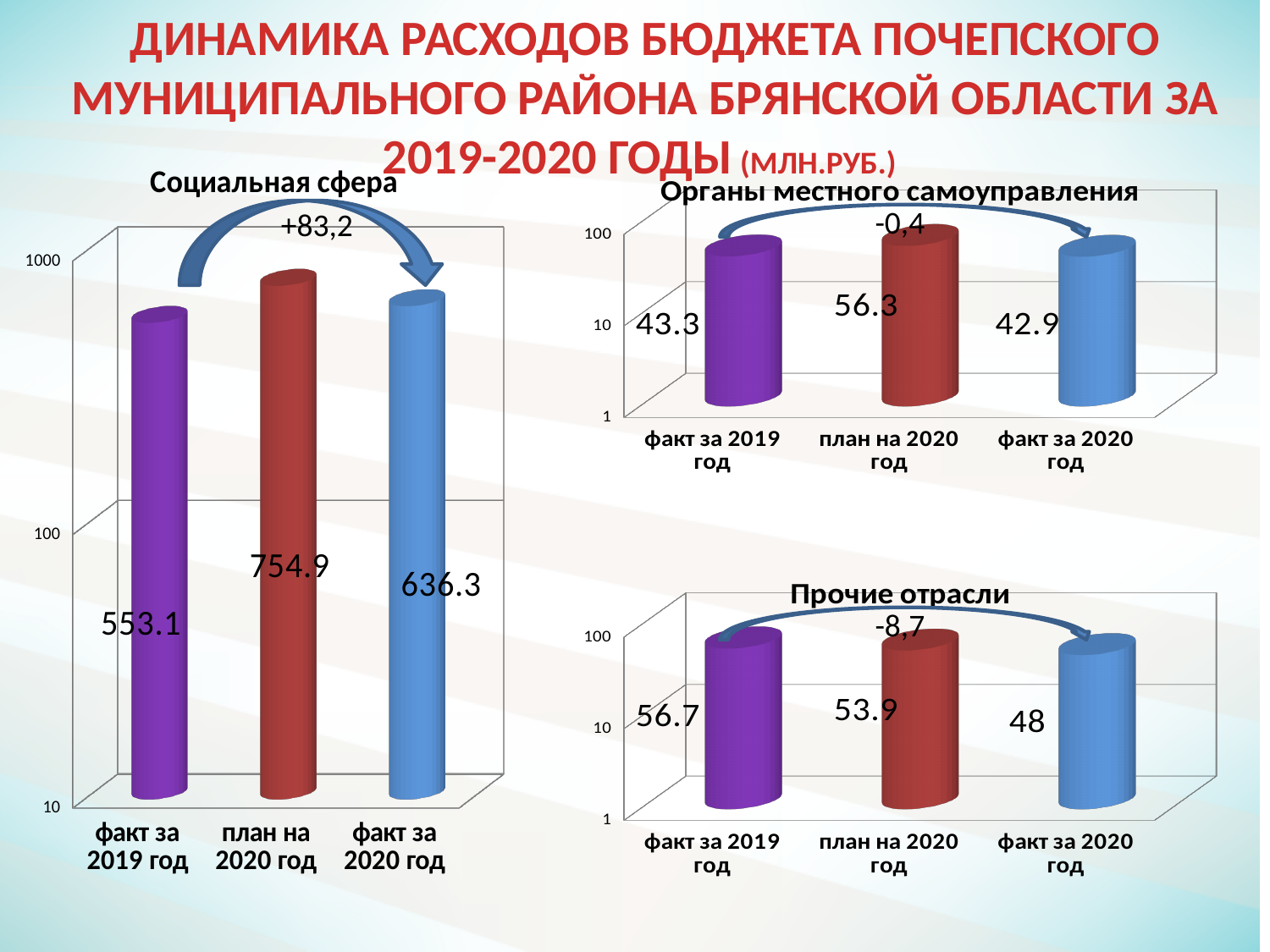
In the 'Социальная сфера' chart, what is the value for 'план на 2020 год'? 754.9 In the 'Органы местного самоуправления' chart, which category has the lowest value? факт за 2020 год In the 'Социальная сфера' chart, which category has the highest value? план на 2020 год In the 'Прочие отрасли' chart, what is the difference between 'факт за 2019 год' and 'факт за 2020 год'? 8.7 In the 'Прочие отрасли' chart, which is larger: 'факт за 2019 год' or 'план на 2020 год'? факт за 2019 год How many bars are shown in the 'Прочие отрасли' chart? 3 In the 'Социальная сфера' chart, what is the value for 'факт за 2019 год'? 553.1 In the 'Социальная сфера' chart, what is the difference between 'факт за 2020 год' and 'факт за 2019 год'? 83.2 In the 'Прочие отрасли' chart, what is the value for 'факт за 2020 год'? 48 In the 'Органы местного самоуправления' chart, what is the value for 'план на 2020 год'? 56.3 What type of chart is the 'Социальная сфера' chart? Bar chart In the 'Органы местного самоуправления' chart, what is the difference between 'факт за 2019 год' and 'факт за 2020 год'? 0.4